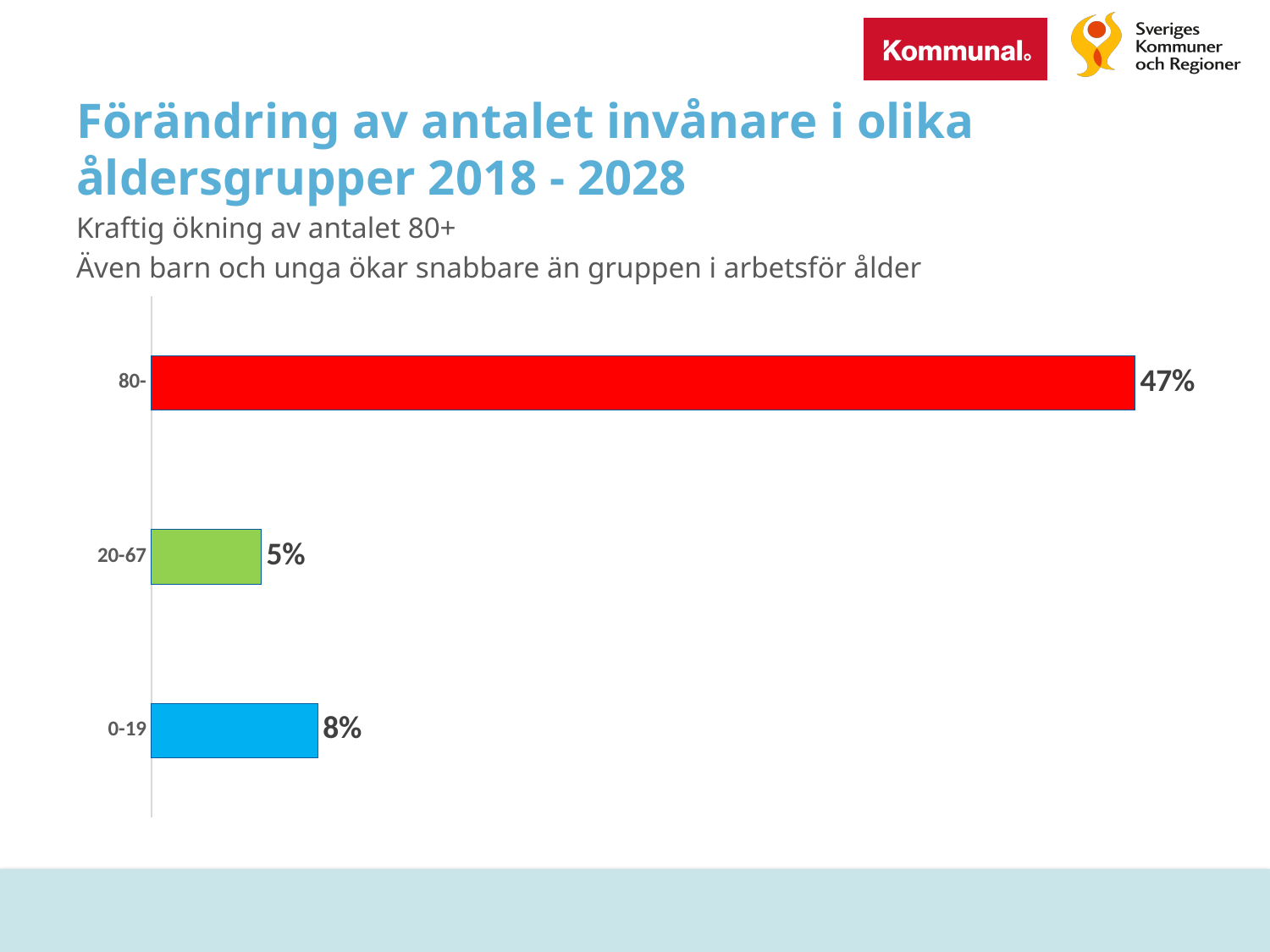
How many age groups are shown in the chart? 3 Which age group has the lowest value? 20-67 What kind of chart is shown on the slide? bar chart What is the value for the 0-19 age group? 8% What is the value for the 20-67 age group? 5% Which has a larger value, 0-19 or 20-67? 0-19 What colour is the bar for the 80- age group? red Which age group has the highest value? 80- What is the difference between the values for 80- and 0-19? 39% What colour is the bar for the 0-19 age group? blue What is the difference between the values for 0-19 and 20-67? 3% What is the value for the 80- age group? 47%